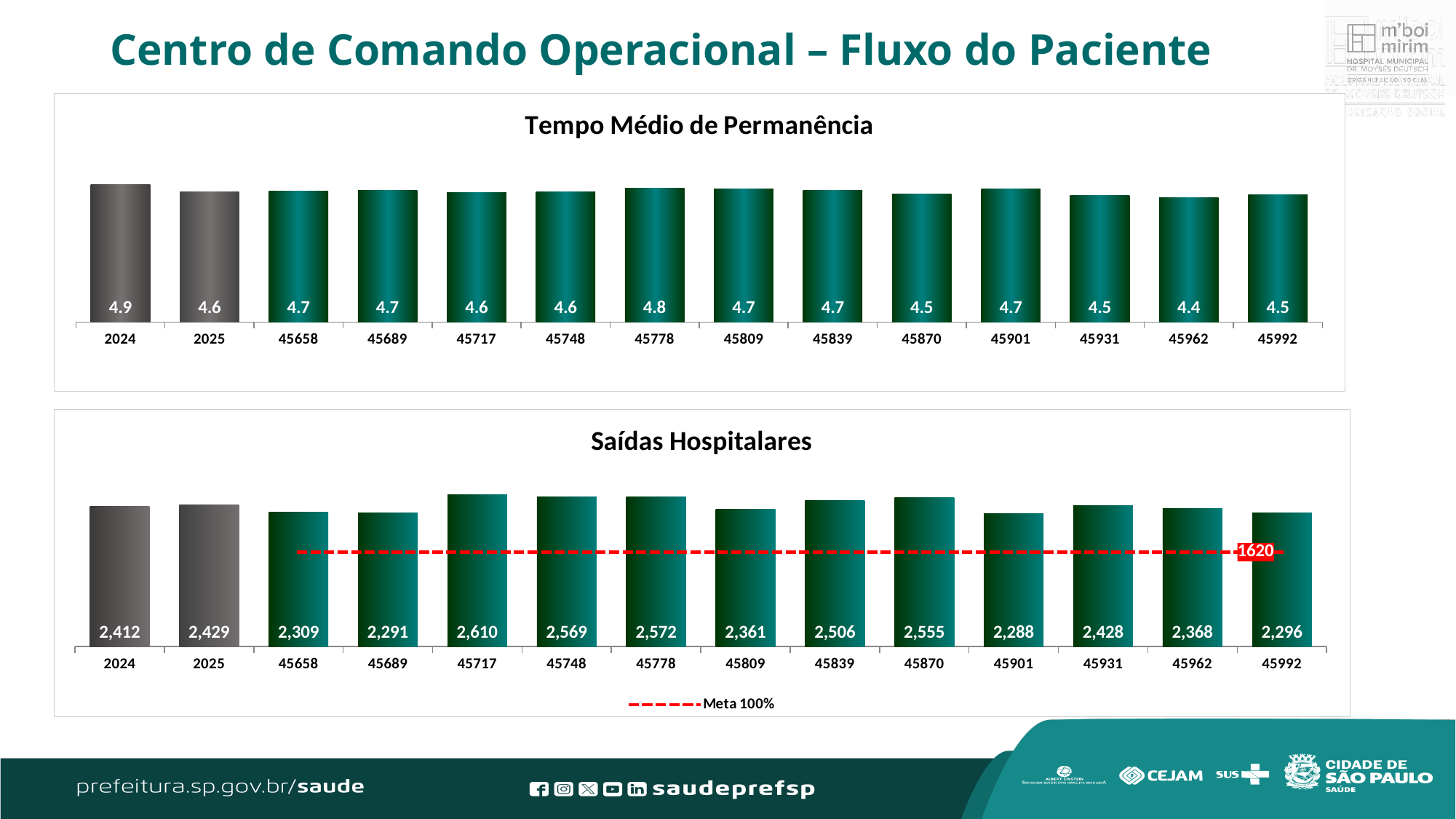
In the 'Saídas Hospitalares' chart, which category has the lowest value? 45901 In the 'Saídas Hospitalares' chart, what is the difference between the values for 45717 and 45901? 322 In the 'Tempo Médio de Permanência' chart, what is the value for 2024? 4.9 In the 'Tempo Médio de Permanência' chart, which category has the lowest value? 45962 What type of chart is 'Tempo Médio de Permanência'? Bar chart In the 'Tempo Médio de Permanência' chart, which category has the highest value? 2024 How many categories are shown on the x axis of the 'Saídas Hospitalares' chart? 14 In the 'Saídas Hospitalares' chart, which category has the highest value? 45717 In the 'Tempo Médio de Permanência' chart, what is the difference between the values for 2024 and 2025? 0.3 In the 'Saídas Hospitalares' chart, what value is labelled on the dashed red 'Meta 100%' line? 1620 In the 'Saídas Hospitalares' chart, which is larger, the value for 2024 or the value for 2025? 2025 In the 'Saídas Hospitalares' chart, what is the value for 45717? 2,610